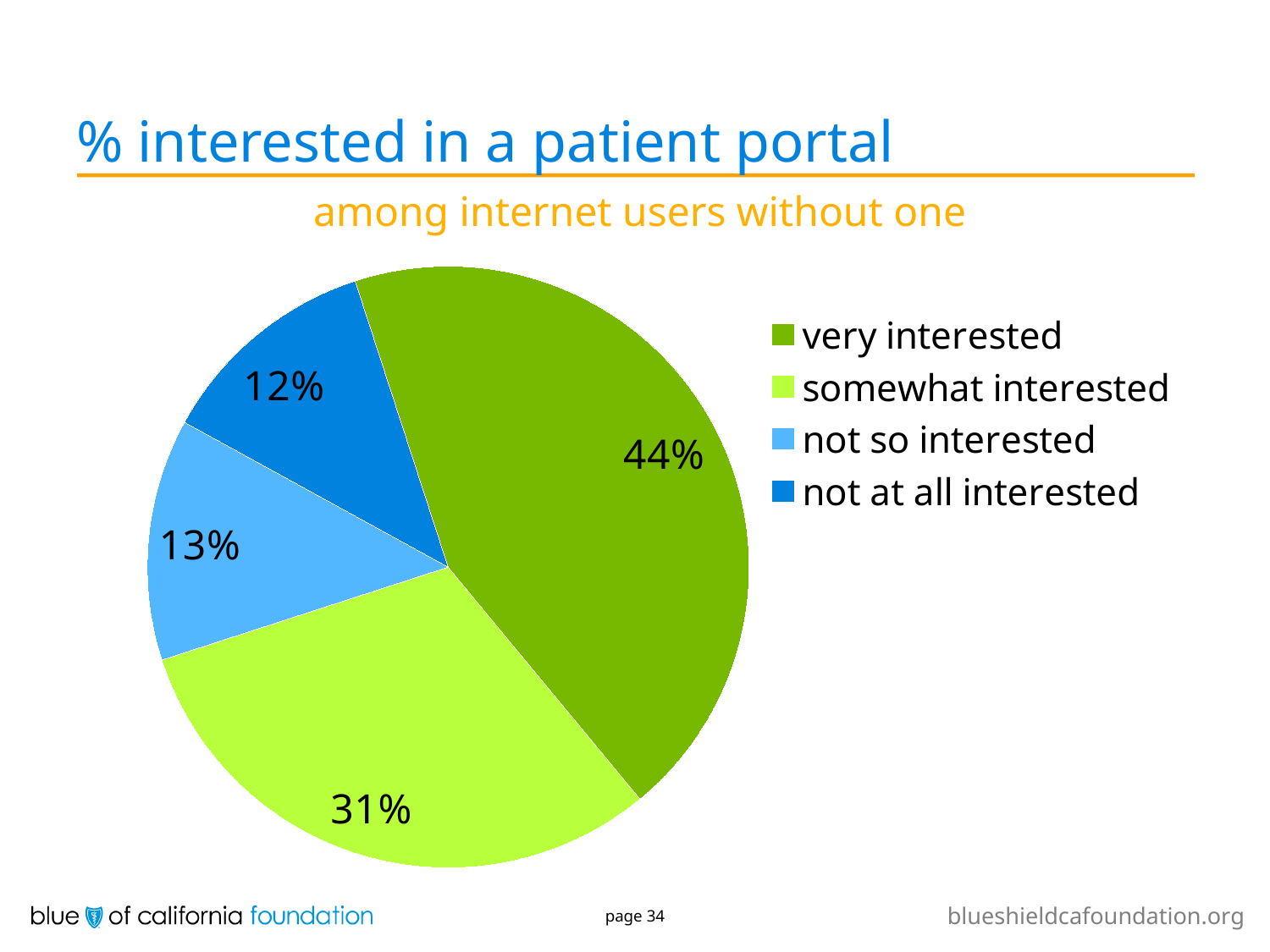
What is the subtitle shown below the chart title? among internet users without one What percentage are somewhat interested in a patient portal? 31% What is the difference in percentage points between very interested and somewhat interested? 13 What is the combined percentage of respondents who are very interested or somewhat interested? 75% What percentage of internet users without a patient portal are very interested in one? 44% Which is larger: the share for somewhat interested or the share for not so interested? somewhat interested What percentage are not at all interested in a patient portal? 12% Which response category has the smallest share of the pie? not at all interested How many categories does the pie chart show? 4 What percentage are not so interested in a patient portal? 13% Which response category has the largest share of the pie? very interested What kind of chart is shown on the slide? pie chart